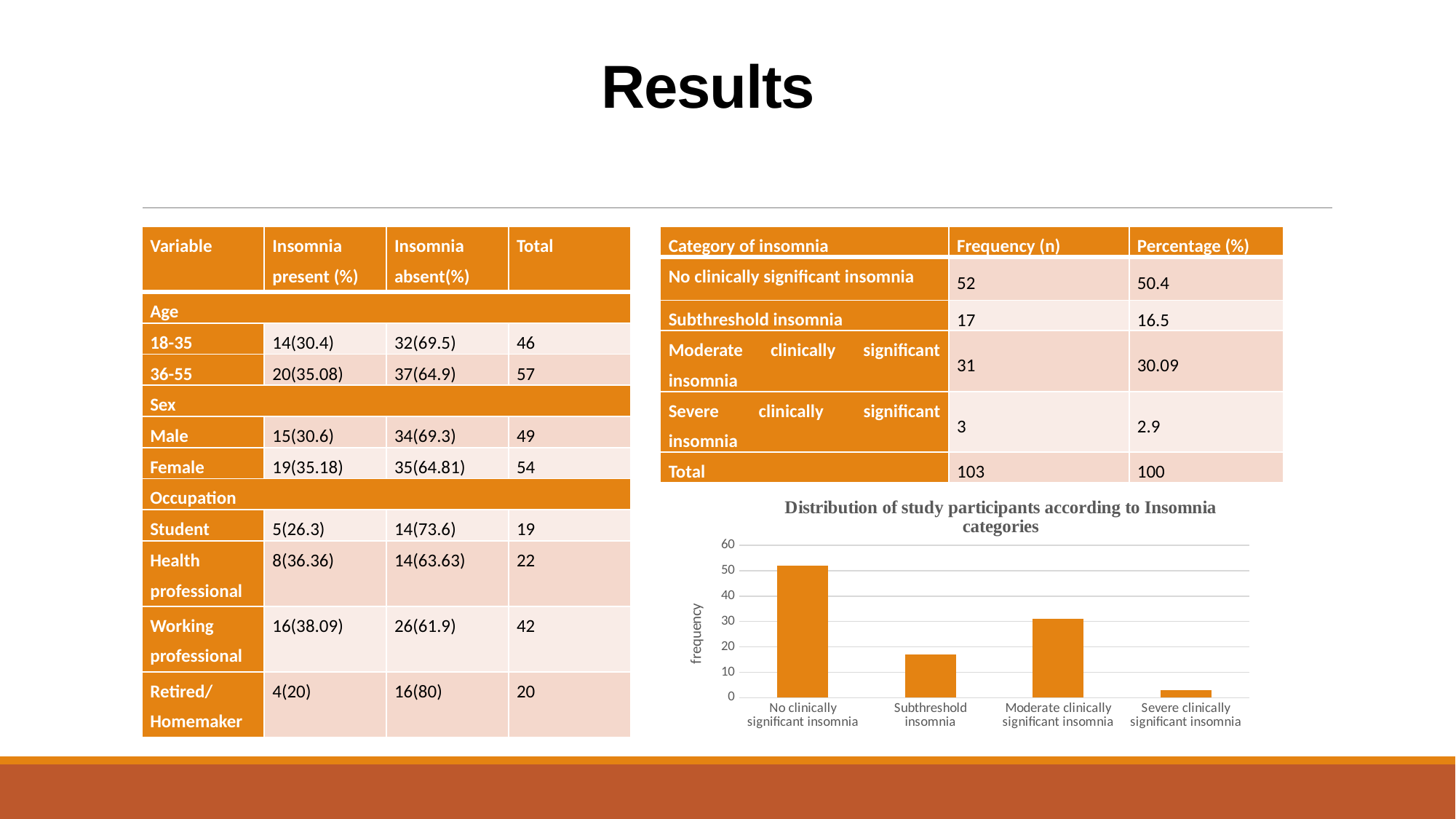
Which insomnia category has the lowest bar in the chart? Severe clinically significant insomnia Which insomnia category has the highest bar in the chart? No clinically significant insomnia What is the title of the chart on the slide? Distribution of study participants according to Insomnia categories How many categories are plotted on the x axis of the chart? 4 Is the value for Severe clinically significant insomnia greater or less than 10? less What is the label of the vertical axis of the chart? frequency Which is larger in the chart, the bar for Subthreshold insomnia or the bar for Moderate clinically significant insomnia? Moderate clinically significant insomnia What kind of chart is shown on the slide? bar chart Is the value for Subthreshold insomnia greater or less than 20? less Is the value for Moderate clinically significant insomnia greater or less than 40? less Do the values fall or rise from No clinically significant insomnia to Subthreshold insomnia in the chart? fall